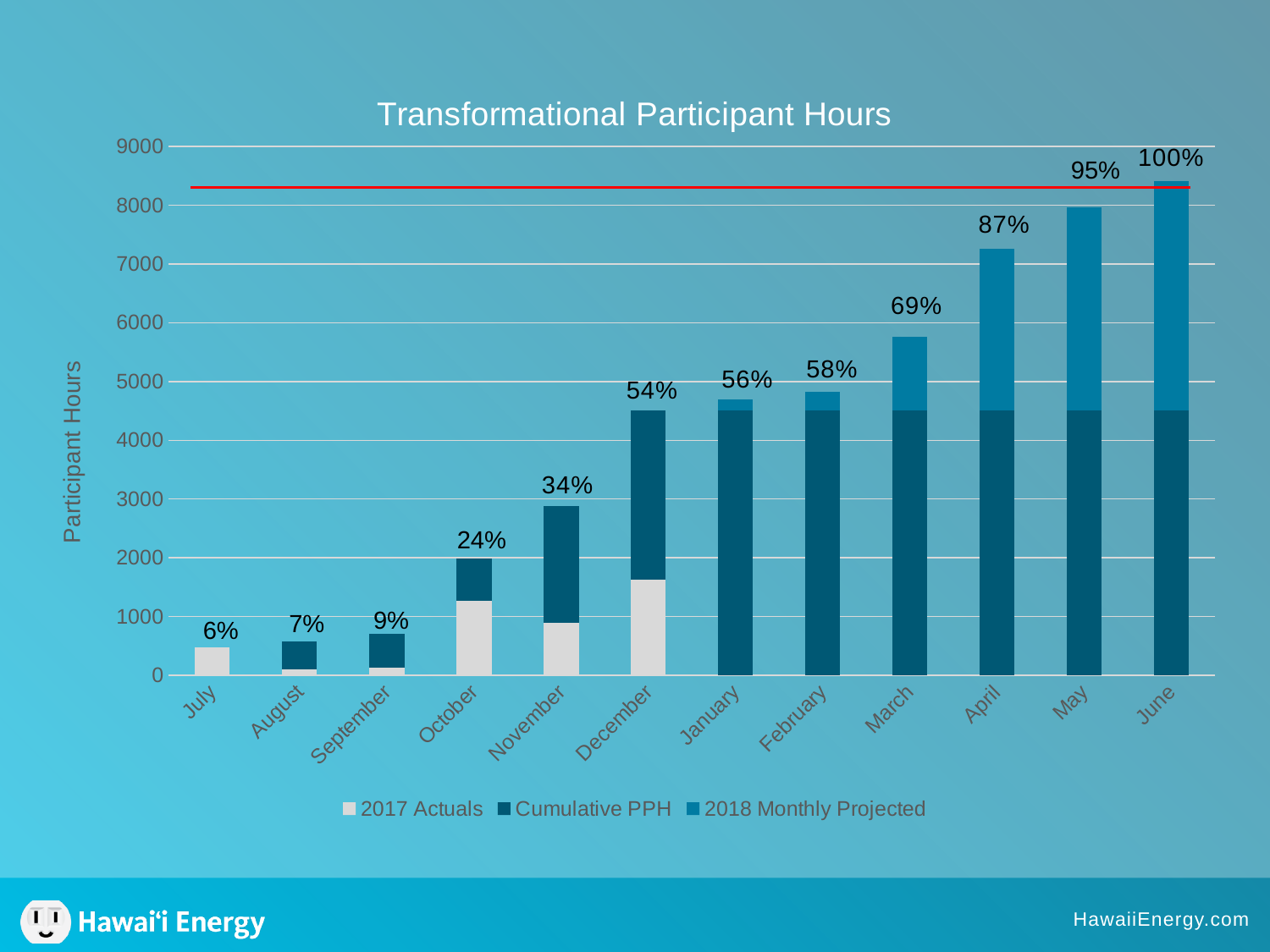
What percentage label is shown above the bar for December? 54% Which month has a larger percentage label, November or February? February How many series does the legend list? 3 Is the total bar height for September greater or less than 1000 participant hours? less What percentage label is shown above the bar for October? 24% What kind of chart is shown on the slide? Stacked bar chart Is the total bar height for June greater or less than 8000 participant hours? greater What is the difference between the percentage labels for May and April? 8% Which month has the lowest percentage label? July Which month has the highest percentage label? June What percentage label is shown above the bar for March? 69% How many months are shown on the x axis? 12